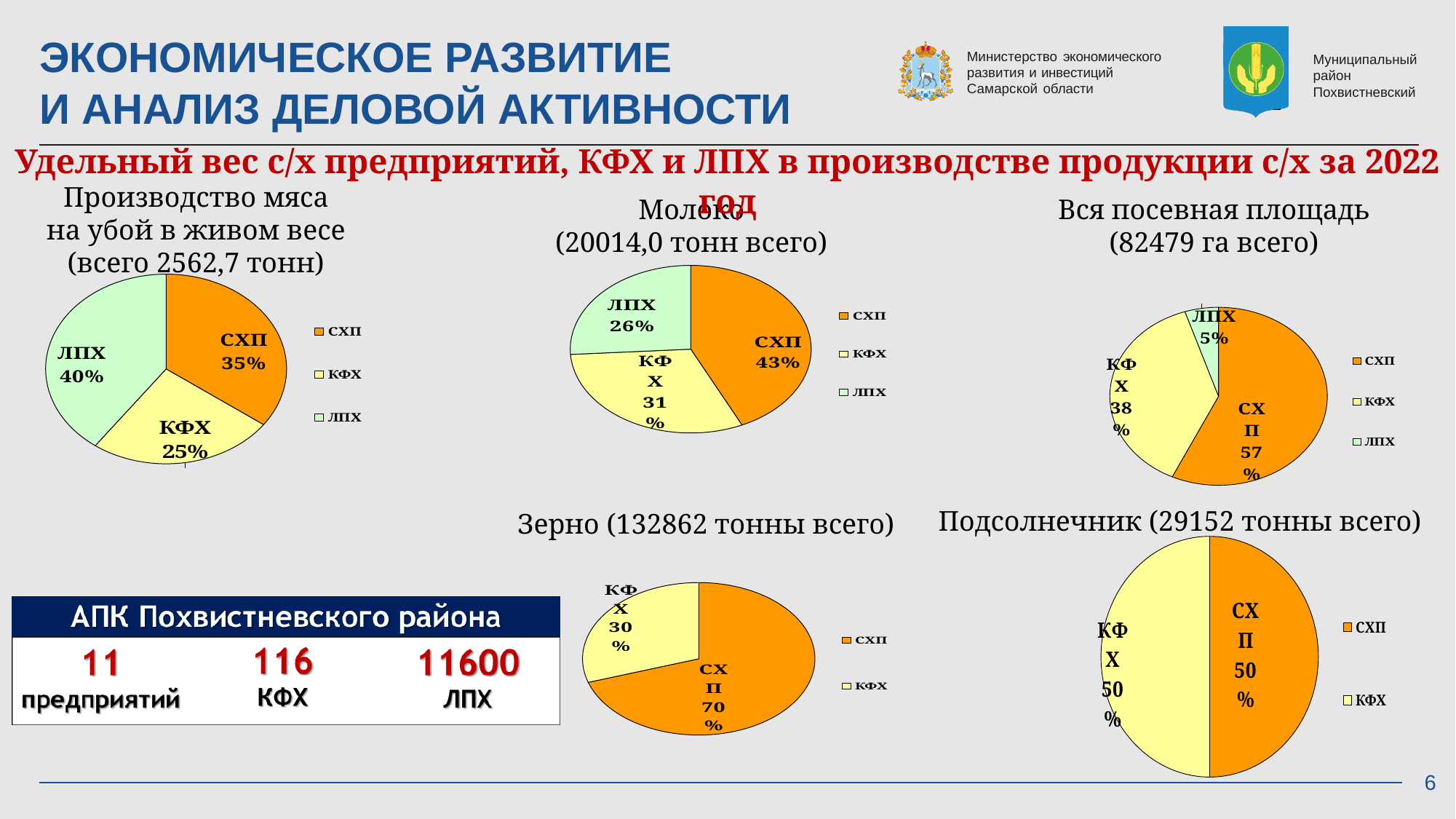
In the Зерно pie chart, what share does КФХ hold? 30% In the meat production pie chart (Производство мяса на убой в живом весе), what share does ЛПХ hold? 40% In the Подсолнечник pie chart, what share does СХП hold? 50% In the Молоко pie chart, what is the difference between the shares of КФХ and ЛПХ? 5% In the Молоко pie chart, which category has the largest share? СХП What type of chart is used for Подсолнечник? Pie chart How many categories does the Зерно pie chart show? 2 In the meat production pie chart (Производство мяса на убой в живом весе), which category has the smallest share? КФХ How many entries does the legend of the Молоко chart list? 3 In the Вся посевная площадь pie chart, which is larger, the share of СХП or the share of КФХ? СХП